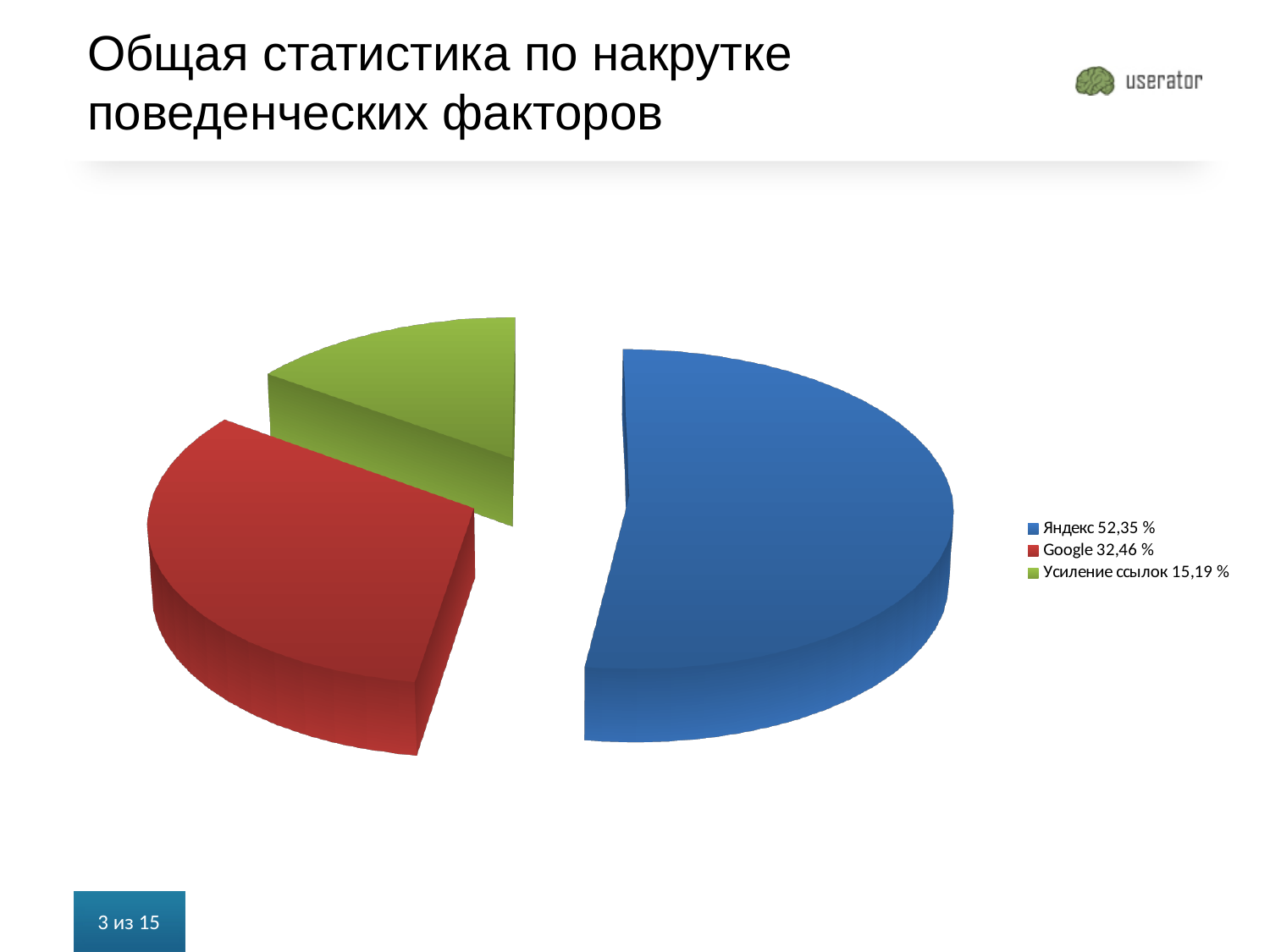
What type of chart is shown on the slide? pie chart What is the value for Яндекс? 52,35 % How many categories does the pie chart have? 3 Which is larger, the value for Google or the value for Усиление ссылок? Google Which category has the largest slice of the pie? Яндекс What is the difference between the values for Google and Усиление ссылок? 17,27 % What is the difference between the values for Яндекс and Google? 19,89 % What share of the pie does Google represent? 32,46 % Which category has the smallest slice of the pie? Усиление ссылок What is the value for Усиление ссылок? 15,19 % What is the value for Google? 32,46 % What colour is the slice for Яндекс? blue